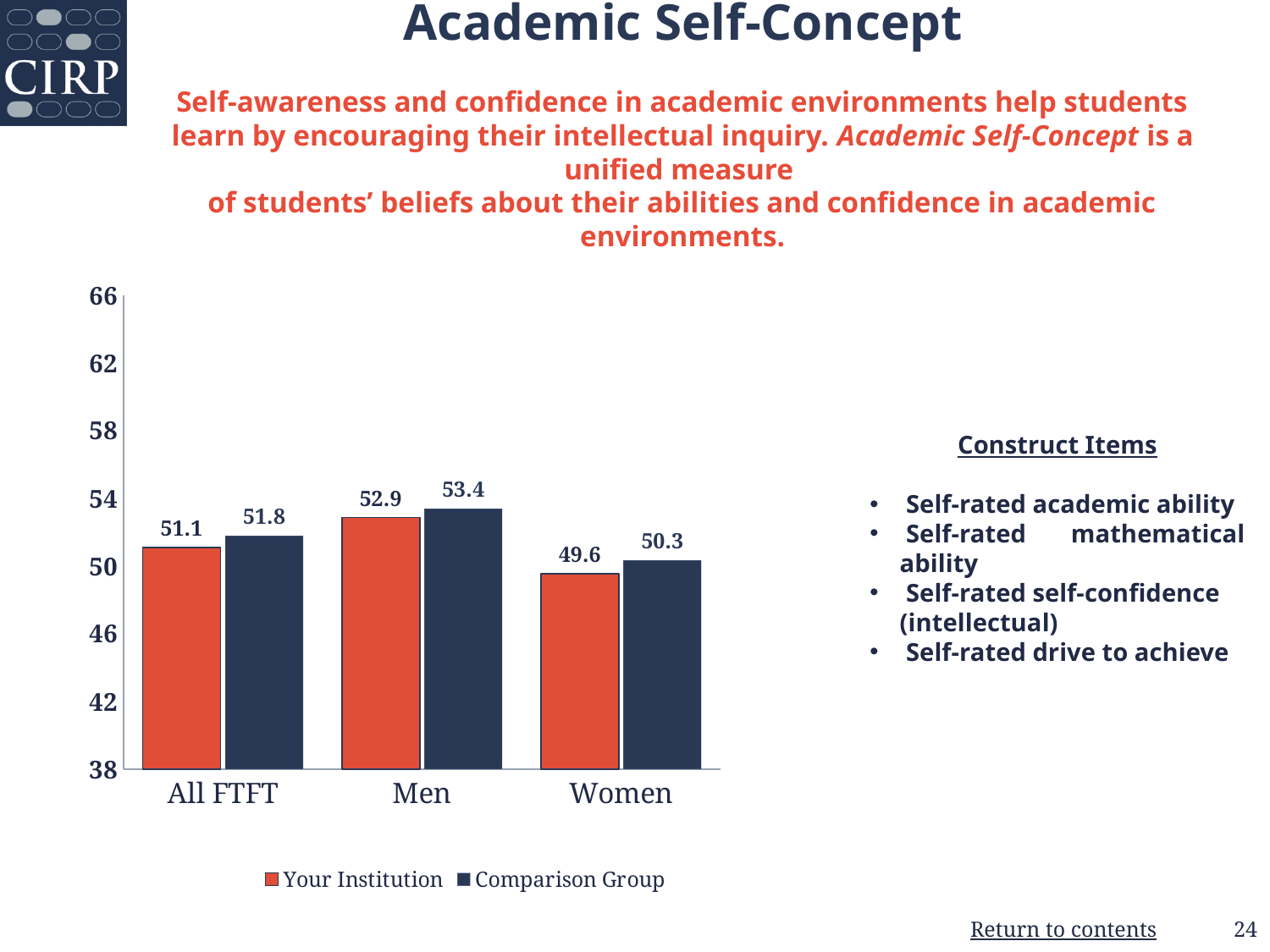
What kind of chart is shown on the slide? bar chart What is the value for Your Institution in the All FTFT category? 51.1 Which category has the lowest value for Your Institution? Women What is the value for Comparison Group in the Men category? 53.4 Which is larger for All FTFT: Your Institution or Comparison Group? Comparison Group Which category has the highest value for Comparison Group? Men What is the difference between the Comparison Group and Your Institution values for Women? 0.7 How many series does the legend list? 2 How many categories are shown on the x axis? 3 What is the value for Your Institution in the Women category? 49.6 Is the value for Your Institution in the Women category greater or less than 50? less What is the difference between the Your Institution values for Men and Women? 3.3